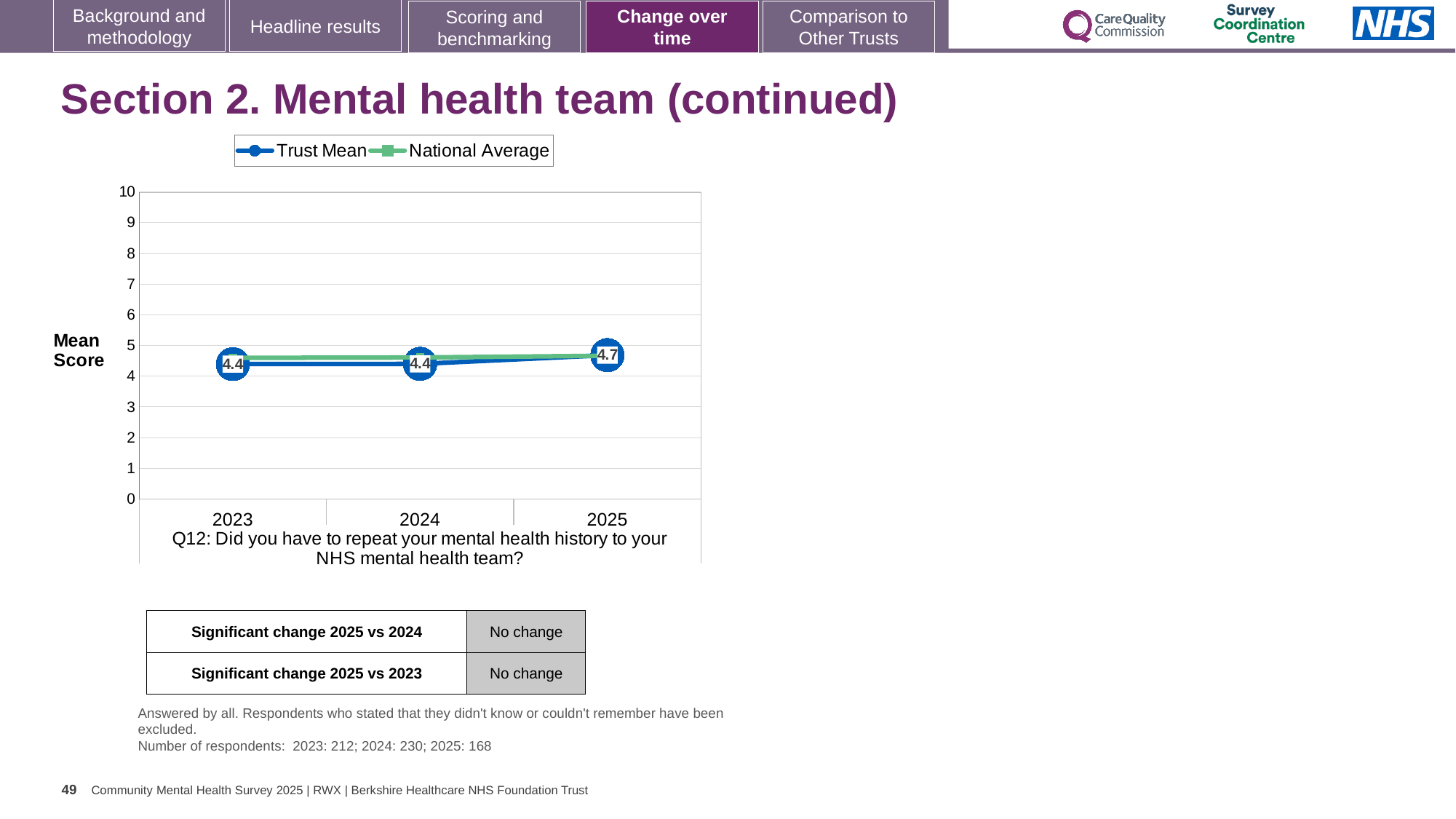
Does the Trust Mean rise or fall from 2023 to 2025? rise What kind of chart is shown on the slide? line chart What is the label on the y axis of the chart? Mean Score What is the Trust Mean value for 2024? 4.4 In which year is the Trust Mean highest? 2025 Is the National Average value for 2023 greater or less than 5? less What is the Trust Mean value for 2025? 4.7 What is the Trust Mean value for 2023? 4.4 How many years are shown on the x axis? 3 What is the difference between the Trust Mean in 2025 and in 2023? 0.3 How many series does the legend list? 2 Which is larger, the Trust Mean in 2025 or the Trust Mean in 2024? 2025